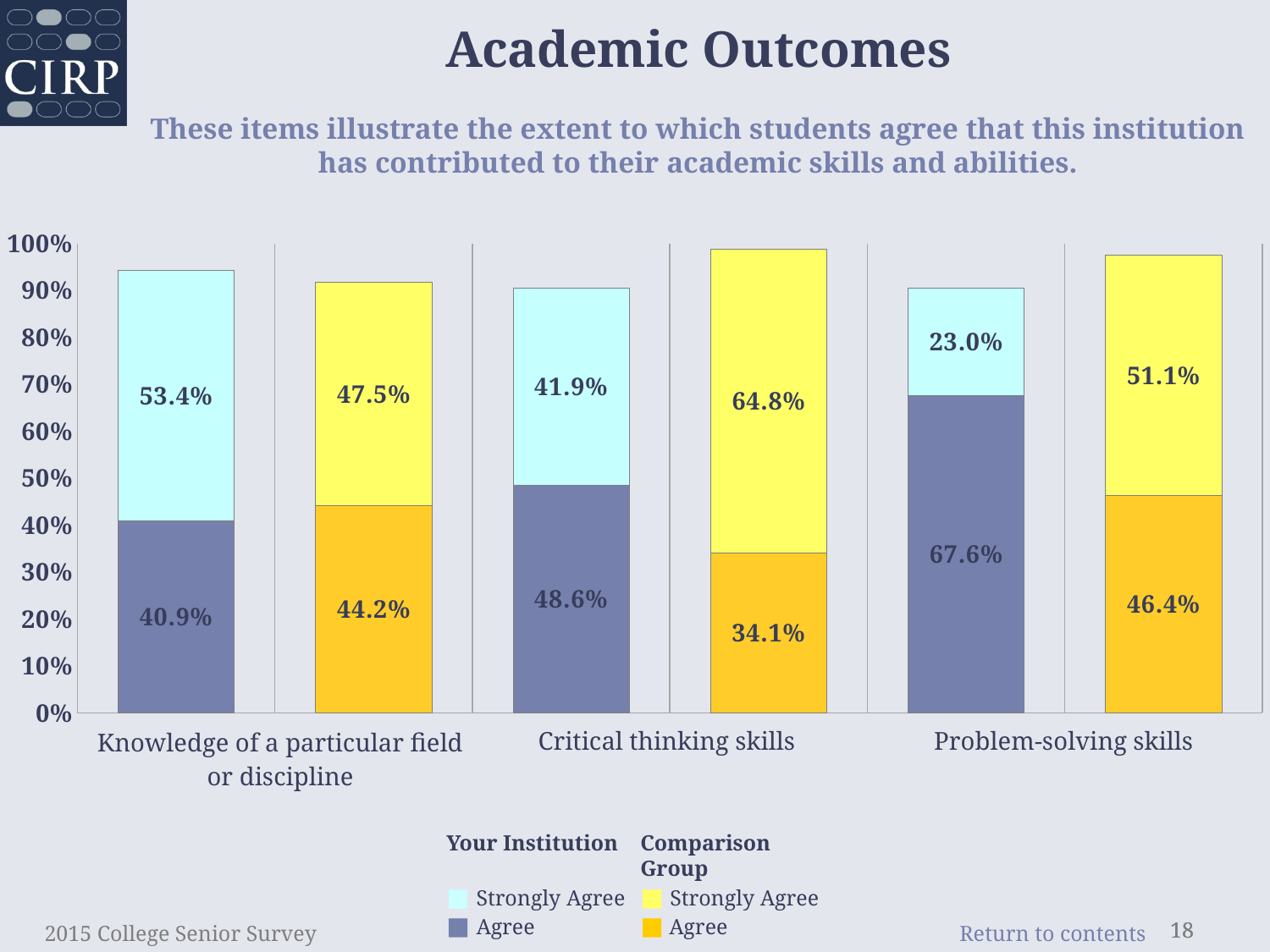
What is the Your Institution Agree value for problem-solving skills? 67.6% How many series does the legend list? 4 What kind of chart is shown on the slide? Stacked bar chart What percentage of students at Your Institution strongly agree that the institution contributed to their knowledge of a particular field or discipline? 53.4% Across all three items, which Strongly Agree value is the highest? 64.8% (Comparison Group, critical thinking skills) What is the combined Agree plus Strongly Agree total for the Comparison Group on problem-solving skills? 97.5% What is the Comparison Group's Agree value for critical thinking skills? 34.1% Which Strongly Agree value is the lowest on the chart? 23.0% (Your Institution, problem-solving skills) What is the difference between the Comparison Group's Strongly Agree value and Your Institution's Strongly Agree value for critical thinking skills? 22.9 percentage points For knowledge of a particular field or discipline, which is larger: Your Institution's Agree value or the Comparison Group's Agree value? Comparison Group (44.2%) What is the combined Agree plus Strongly Agree total for Your Institution on knowledge of a particular field or discipline? 94.3% What is the Comparison Group's Strongly Agree value for problem-solving skills? 51.1%